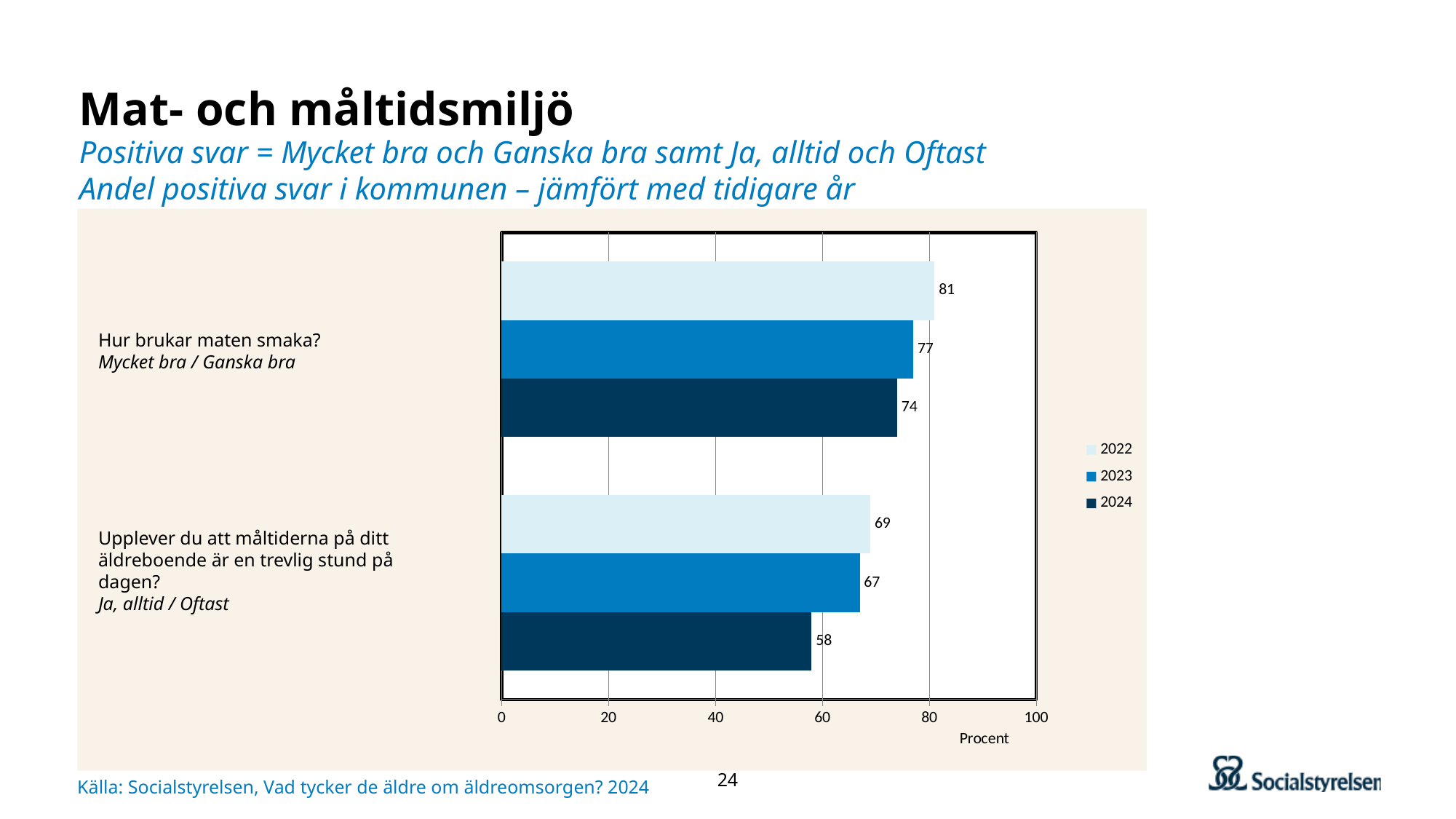
Do the values for "Upplever du att måltiderna på ditt äldreboende är en trevlig stund på dagen?" rise or fall from 2022 to 2024? Fall What is the difference between the 2023 and 2024 values for "Upplever du att måltiderna på ditt äldreboende är en trevlig stund på dagen?"? 9 What is the 2023 value for "Hur brukar maten smaka?"? 77 What is the difference between the 2022 and 2024 values for "Hur brukar maten smaka?"? 7 Which year has the lowest value for "Upplever du att måltiderna på ditt äldreboende är en trevlig stund på dagen?"? 2024 What kind of chart is shown on the slide? Bar chart Which is larger: the 2024 value for "Hur brukar maten smaka?" or the 2022 value for "Upplever du att måltiderna på ditt äldreboende är en trevlig stund på dagen?"? 2024 value for "Hur brukar maten smaka?" How many series does the legend list? 3 What is the 2024 value for "Upplever du att måltiderna på ditt äldreboende är en trevlig stund på dagen?"? 58 What is the 2022 value for "Hur brukar maten smaka?"? 81 Which year has the highest value for "Hur brukar maten smaka?"? 2022 How many questions (categories) are shown in the chart? 2